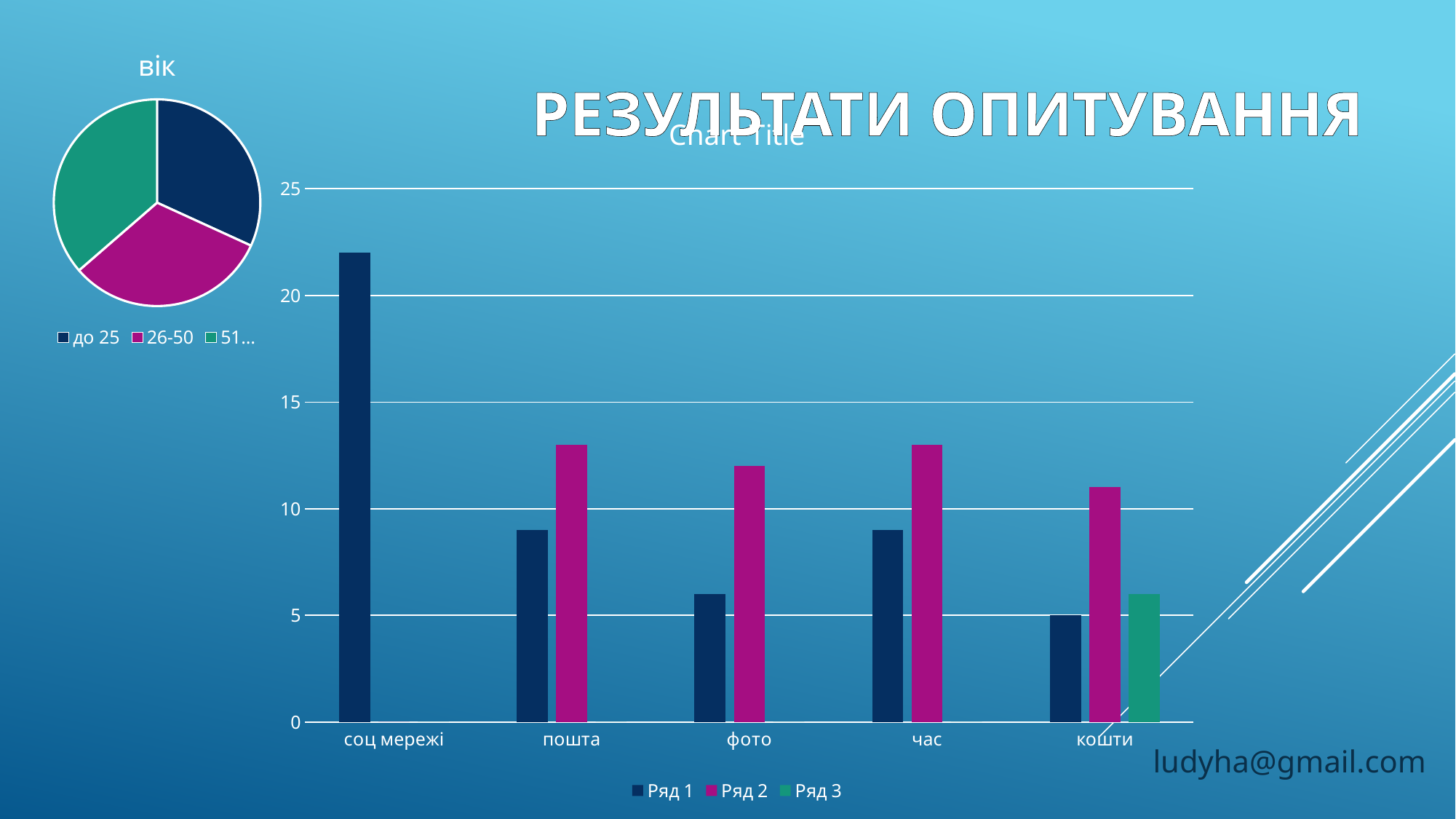
In the chart titled "Chart Title", how many categories have a Ряд 3 bar? 1 In the chart titled "Chart Title", which category has the highest Ряд 1 value? соц мережі What kind of chart is the chart titled "Chart Title"? bar chart In the chart titled "Chart Title", what is the Ряд 1 value for кошти? 5 In the chart titled "Chart Title", how many categories are shown on the x axis? 5 In the chart titled "Chart Title", is the Ряд 1 value for соц мережі greater or less than 20? greater In the chart titled "Chart Title", is the Ряд 1 value for фото greater or less than 10? less How many slices does the pie chart titled "вік" have? 3 What kind of chart is the chart titled "вік"? pie chart In the chart titled "Chart Title", for пошта, which series has the larger value, Ряд 1 or Ряд 2? Ряд 2 In the chart titled "Chart Title", how many series does the legend list? 3 In the chart titled "Chart Title", is the Ряд 2 value for пошта greater or less than 10? greater